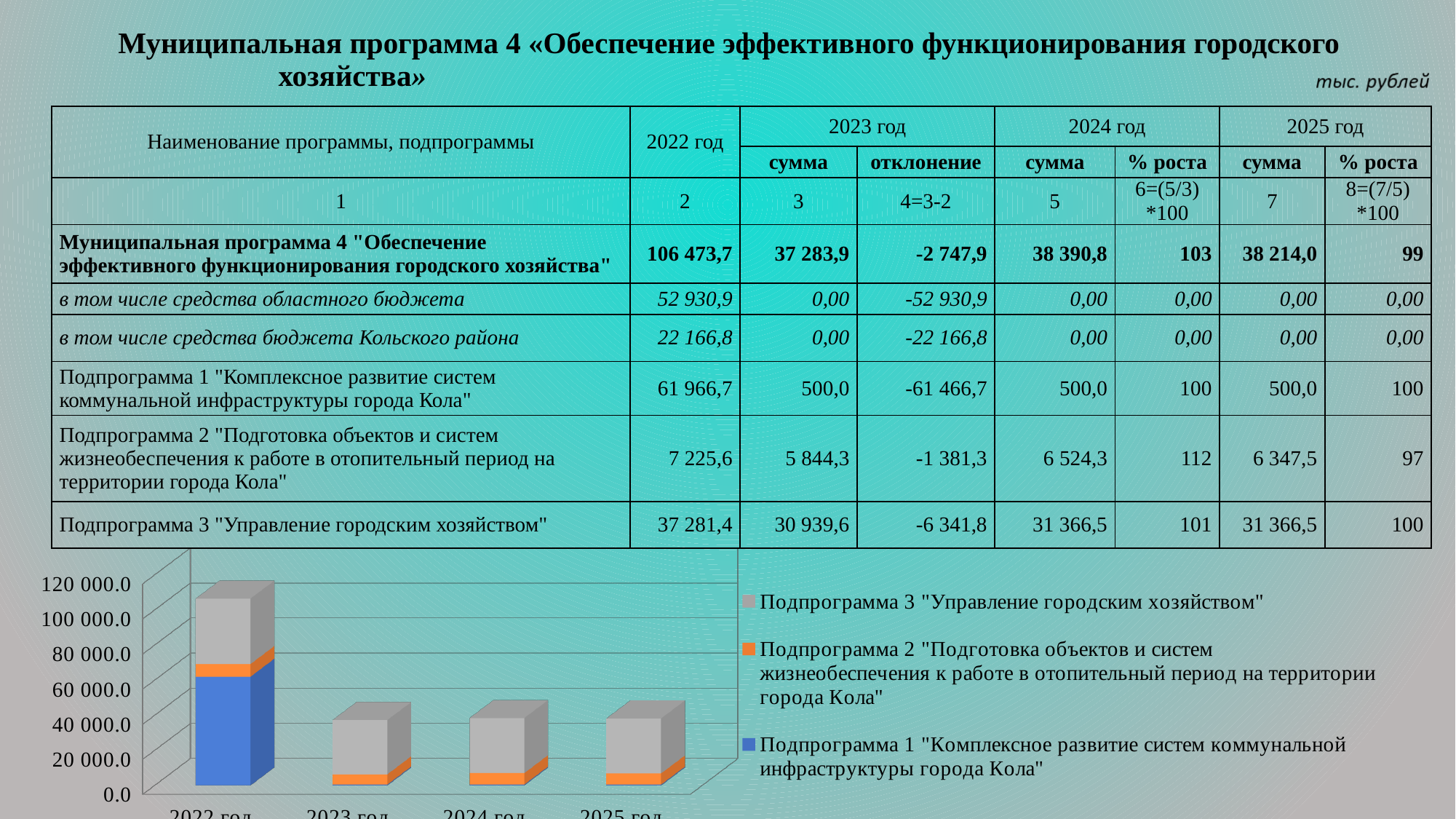
Which series is shown at the top of each stacked bar in the chart? Подпрограмма 3 "Управление городским хозяйством" Is the total height of the 2025 год bar greater or less than 20 000.0? greater How many series does the chart legend list? 3 Which colour represents Подпрограмма 1 "Комплексное развитие систем коммунальной инфраструктуры города Кола" in the chart? blue What kind of chart is shown at the bottom of the slide? bar chart Does the total bar height rise or fall from 2022 год to 2023 год? fall Is the total height of the 2023 год bar greater or less than 60 000.0? less How many years (categories) are shown on the x axis of the chart? 4 Which bar is taller in the chart, 2022 год or 2023 год? 2022 год Which year has the tallest stacked bar in the chart? 2022 год According to the table, what is the total of the stacked bar for 2022 год (the municipal programme total)? 106 473,7 Is the total height of the 2022 год bar greater or less than 100 000.0? greater